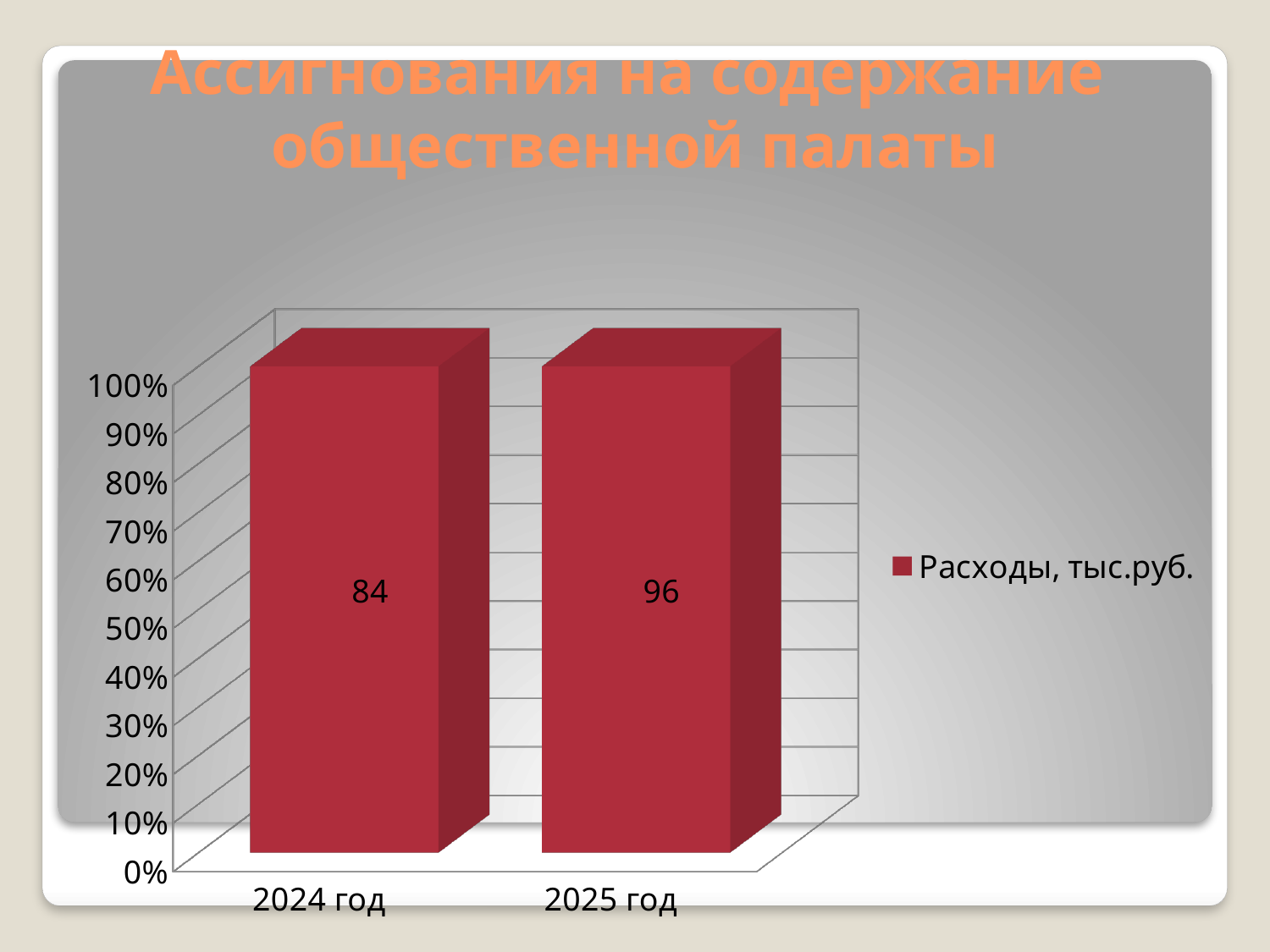
What is the legend entry for the series? Расходы, тыс.руб. Do the labelled values rise or fall from 2024 год to 2025 год? rise What is the difference between the labelled values for 2025 год and 2024 год? 12 What kind of chart is shown on the slide? bar chart How many series does the legend list? 1 What is the value shown for 2024 год? 84 What is the value shown for 2025 год? 96 Is the labelled value for 2024 год larger or smaller than the value for 2025 год? smaller How many categories are shown on the x axis? 2 What is the title of the chart? Ассигнования на содержание общественной палаты Which year has the lower labelled value? 2024 год Which year has the higher labelled value? 2025 год